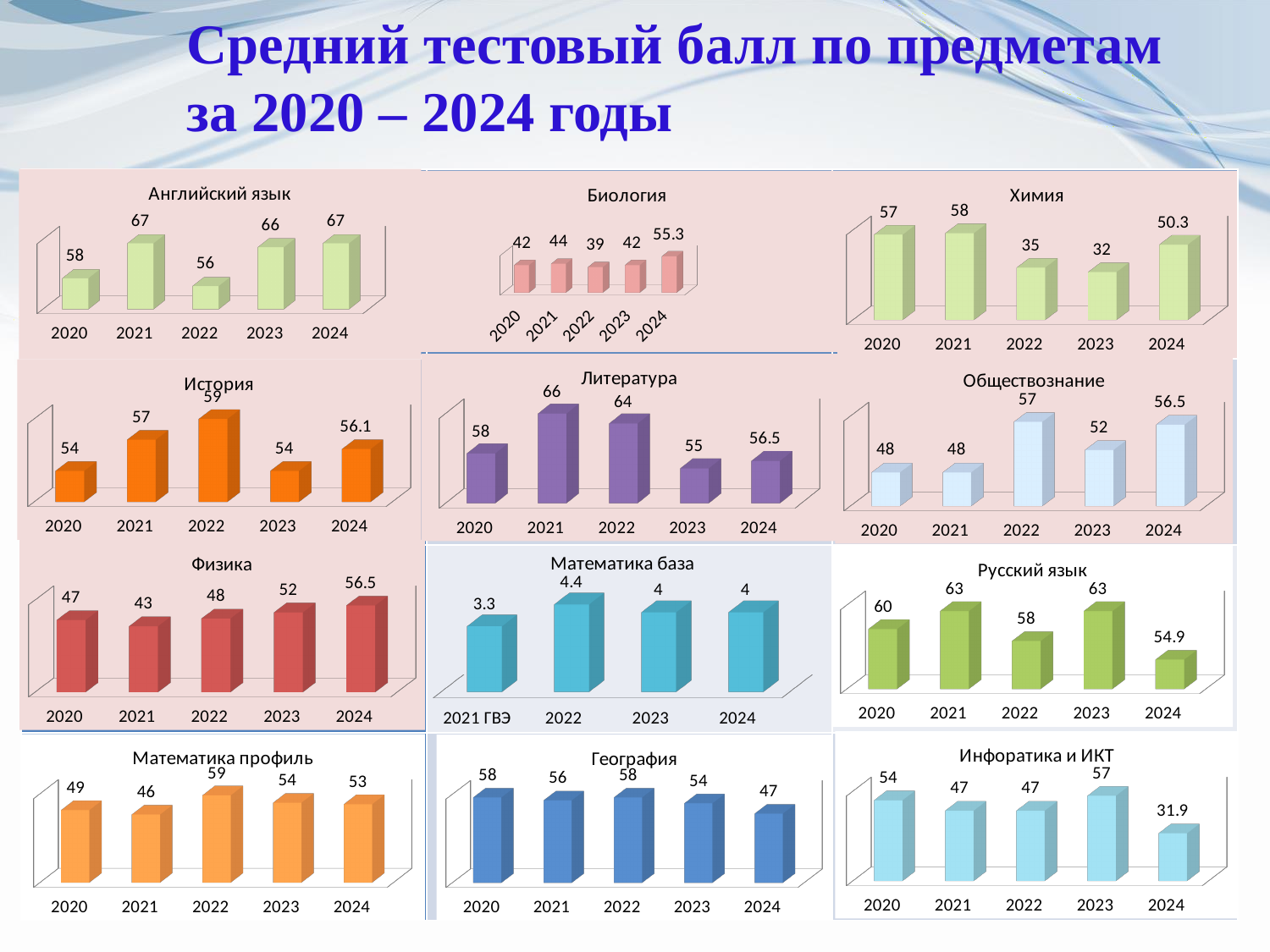
In the 'Английский язык' chart, what is the value for 2022? 56 In the 'Математика профиль' chart, what is the difference between the values for 2022 and 2021? 13 In the 'Русский язык' chart, what is the value for 2024? 54.9 In the 'Математика база' chart, how many categories are shown on the x axis? 4 In the 'Литература' chart, which is larger, the value for 2021 or the value for 2024? 2021 In the 'Биология' chart, which year has the highest value? 2024 What kind of chart is the 'География' chart? bar chart In the 'Обществознание' chart, what is the value for 2024? 56.5 In the 'Инфоратика и ИКТ' chart, what is the value for 2024? 31.9 In the 'Химия' chart, which year has the lowest value? 2023 In the 'Физика' chart, do the values rise or fall from 2021 to 2024? rise In the 'История' chart, what is the difference between the values for 2022 and 2020? 5